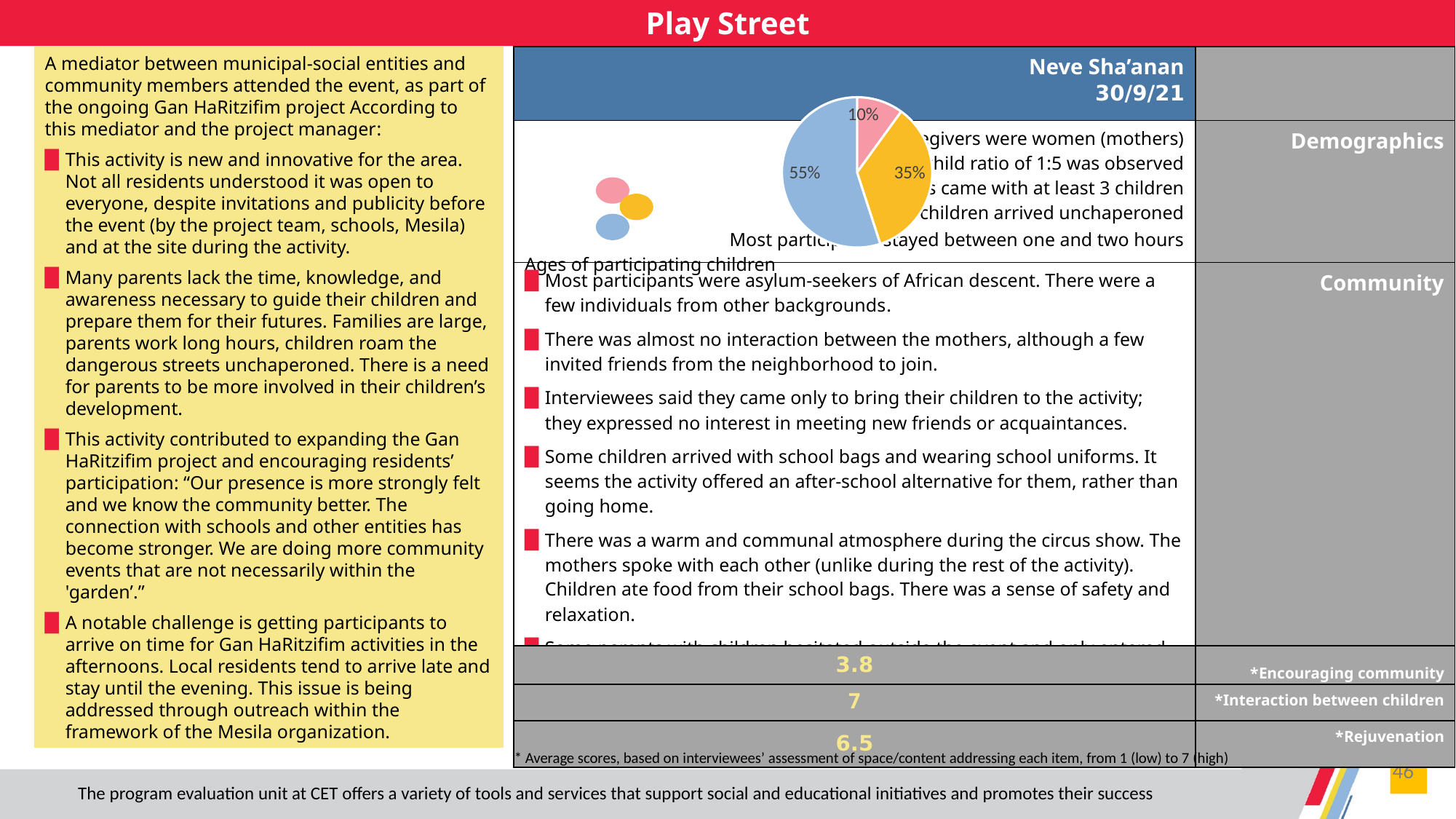
What is the largest percentage shown in the pie chart? 55% What is the difference in percentage points between the light blue slice and the orange slice? 20 What is the smallest percentage shown in the pie chart? 10% What percentage is shown for the orange slice of the pie chart? 35% What kind of chart is shown on the slide? pie chart What is the difference in percentage points between the largest and smallest slices of the pie chart? 45 What percentage is shown for the pink slice of the pie chart? 10% What percentage is shown for the light blue slice of the pie chart? 55% Which slice is larger, the orange slice or the pink slice? orange slice Does the largest slice of the pie chart account for more or less than half of the total? more What is the title of the pie chart? Ages of participating children How many slices does the pie chart have? 3